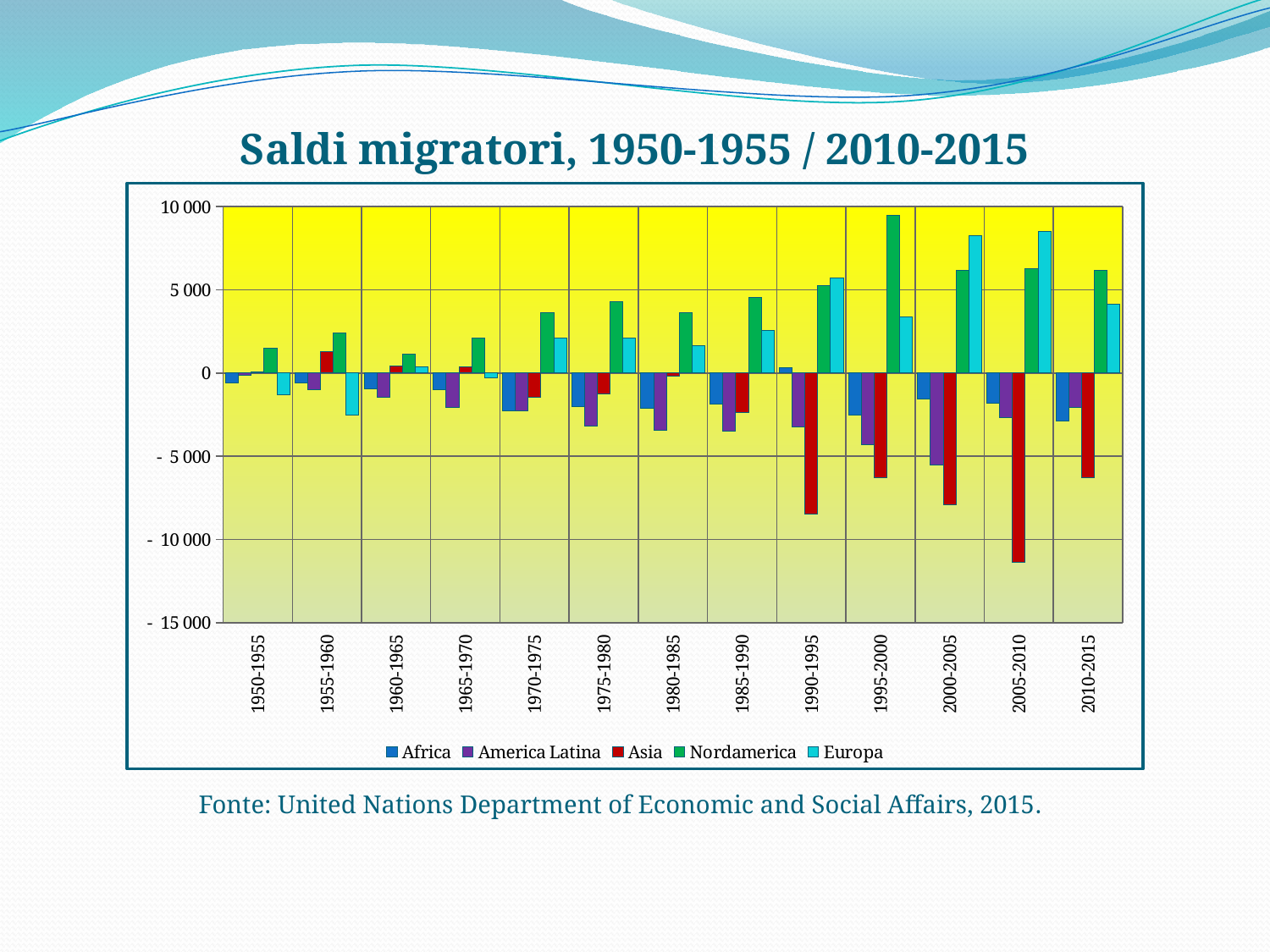
How many series does the legend list? 5 What kind of chart is shown on the slide? bar chart Is the value for Africa in 2010-2015 greater or less than -5 000? greater Which series is shown in red in the legend? Asia In which period does Asia reach its lowest value? 2005-2010 Is the value for Asia in 1990-1995 greater or less than -5 000? less Is the value for Nordamerica in 1995-2000 greater or less than 5 000? greater In which period does Nordamerica reach its highest value? 1995-2000 In 1995-2000, which is larger, the value for Nordamerica or the value for Europa? Nordamerica How many time periods are shown on the x axis? 13 What is the title of the chart? Saldi migratori, 1950-1955 / 2010-2015